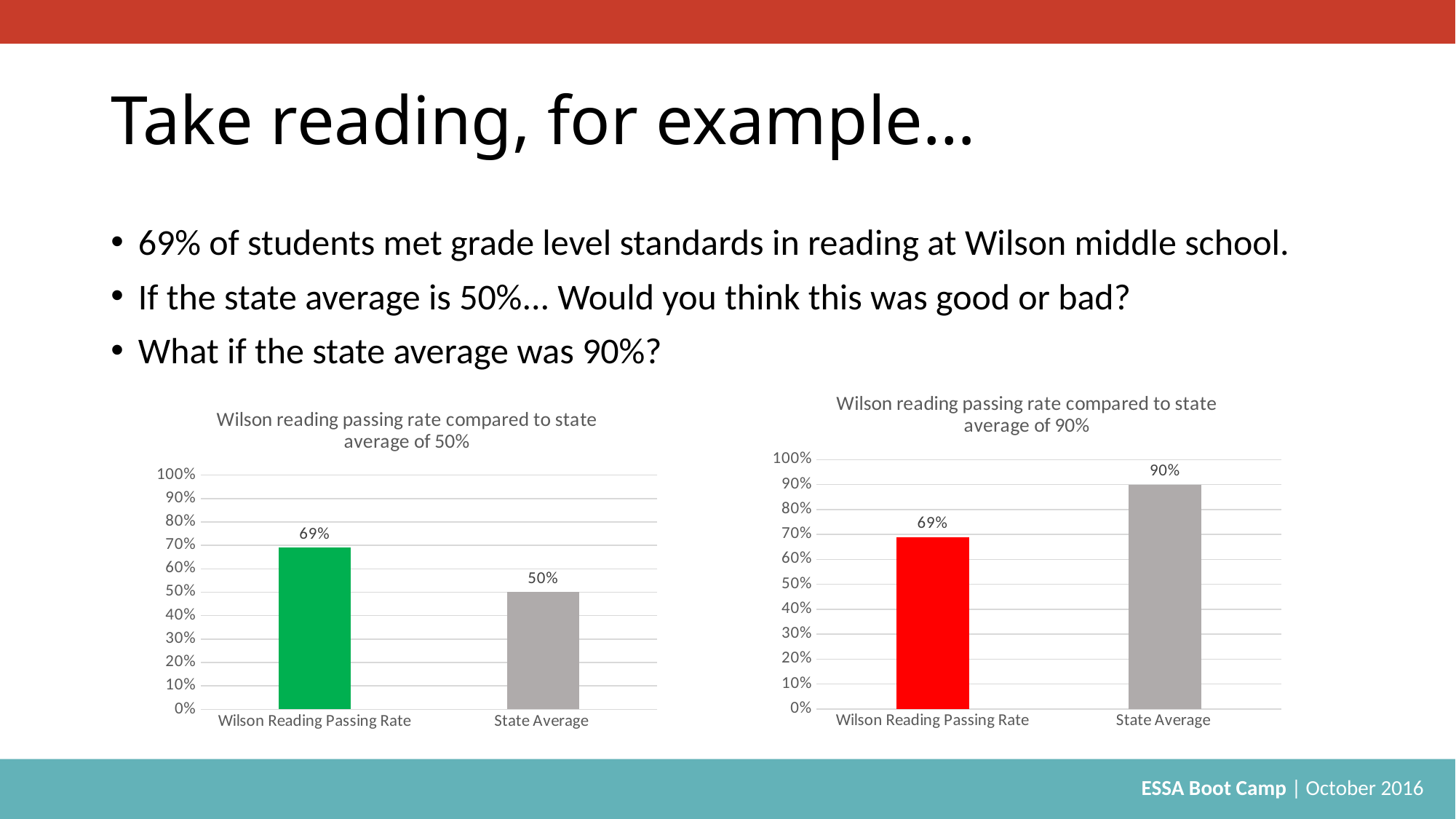
In the right chart (state average of 90%), what is the value for State Average? 90% What colour is the Wilson Reading Passing Rate bar in the right chart (state average of 90%)? Red What kind of chart is the right chart (state average of 90%)? Bar chart In the left chart (state average of 50%), what is the value for Wilson Reading Passing Rate? 69% In the right chart (state average of 90%), what is the difference between State Average and Wilson Reading Passing Rate? 21% In the left chart (state average of 50%), what is the difference between Wilson Reading Passing Rate and State Average? 19% In the left chart (state average of 50%), which category has the highest value? Wilson Reading Passing Rate In the right chart (state average of 90%), which category has the lowest value? Wilson Reading Passing Rate In the left chart (state average of 50%), what is the value for State Average? 50% In the right chart (state average of 90%), which is larger: Wilson Reading Passing Rate or State Average? State Average How many categories are shown in the left chart (state average of 50%)? 2 In the right chart (state average of 90%), what is the value for Wilson Reading Passing Rate? 69%